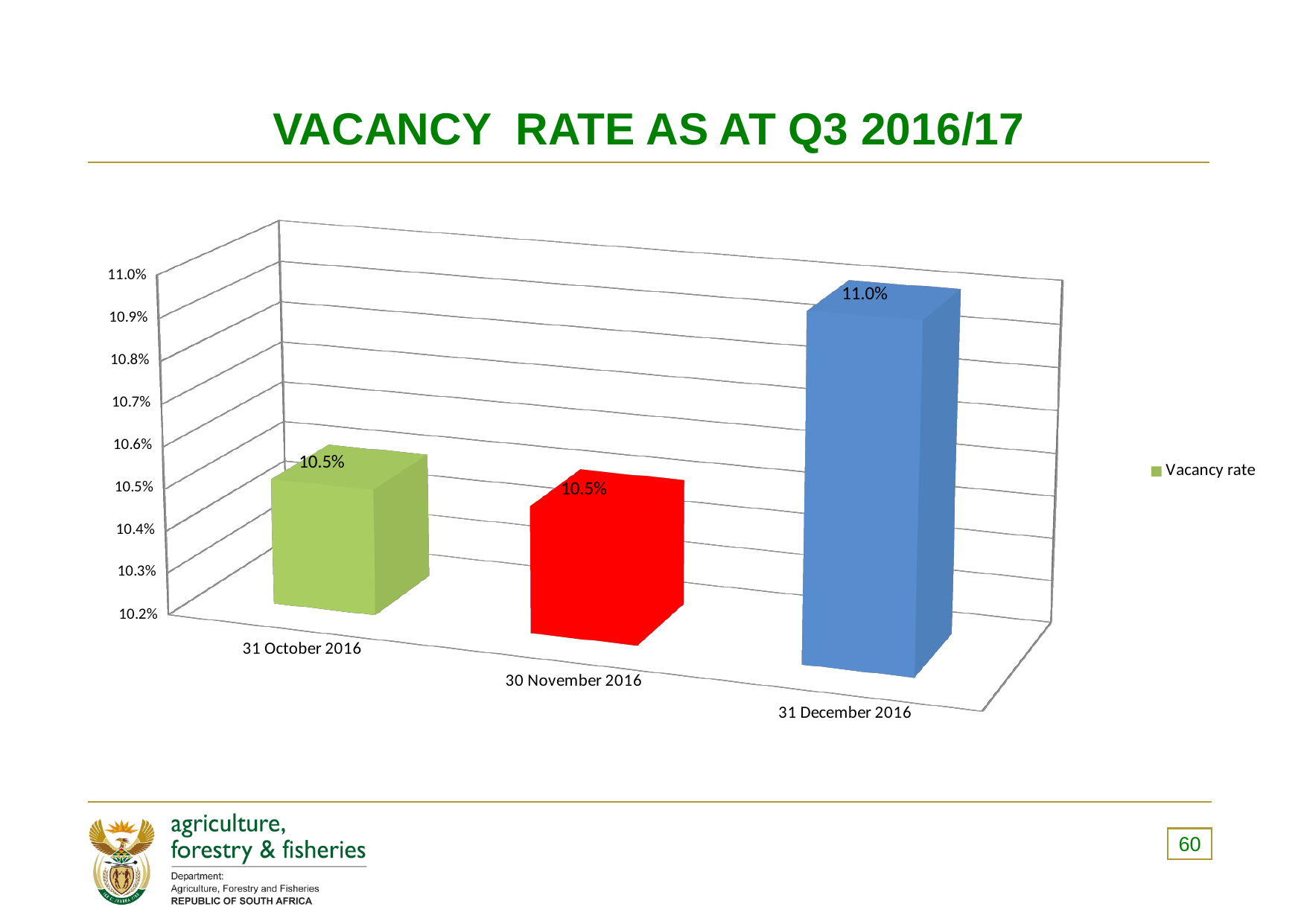
How many series does the legend list? 1 Is the vacancy rate for 31 October 2016 greater or less than 10.8%? less What kind of chart is shown on the slide? bar chart Is the vacancy rate for 31 December 2016 greater or less than 10.8%? greater Which date has the highest vacancy rate? 31 December 2016 How many dates are shown on the chart? 3 What is the vacancy rate for 31 October 2016? 10.5% What is the title of the slide? VACANCY RATE AS AT Q3 2016/17 Which is larger, the vacancy rate on 30 November 2016 or on 31 December 2016? 31 December 2016 What is the difference between the vacancy rate on 31 December 2016 and on 31 October 2016? 0.5% What is the vacancy rate for 30 November 2016? 10.5% What is the vacancy rate for 31 December 2016? 11.0%